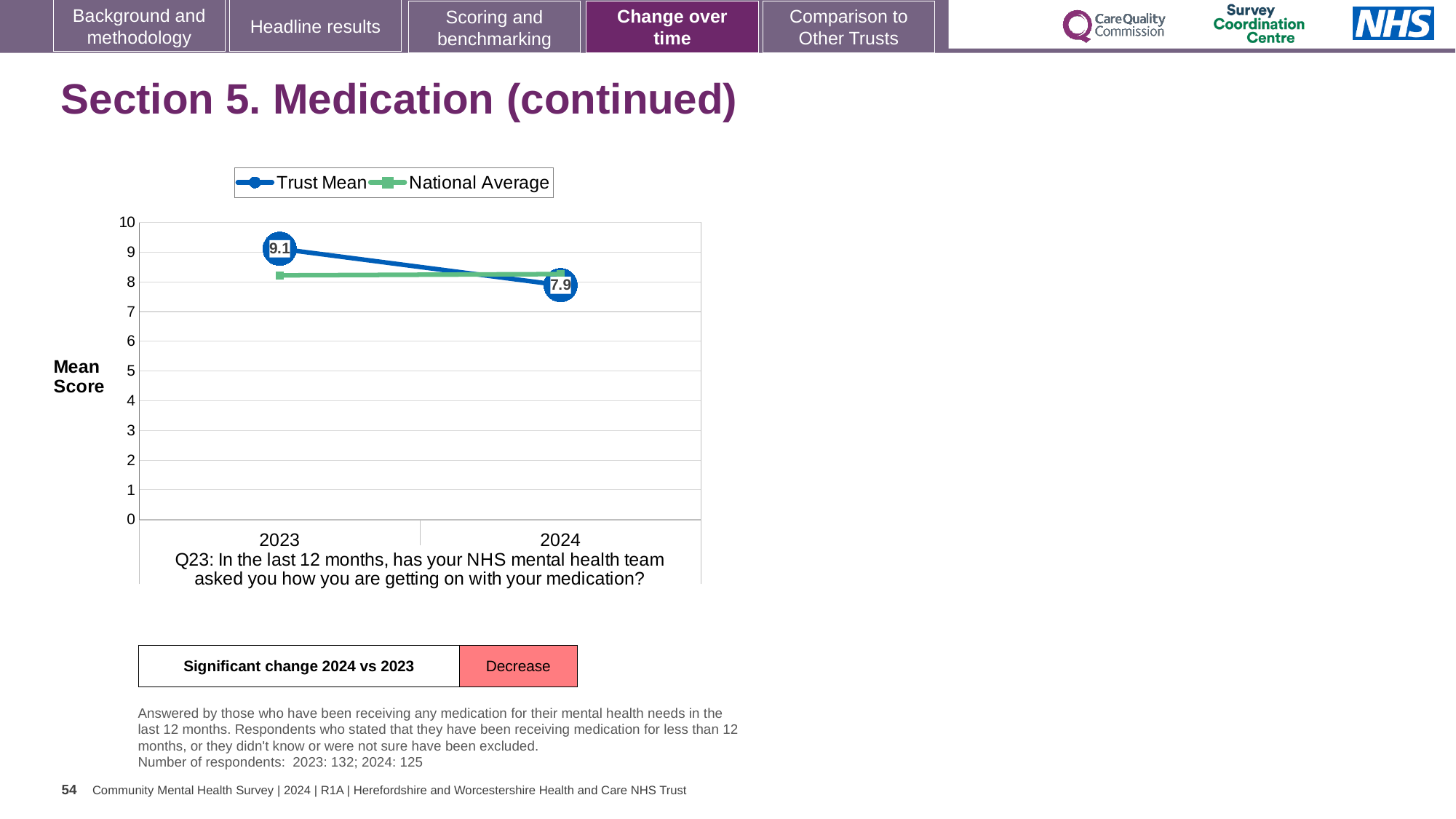
How many years are shown on the x axis? 2 Is the National Average value for 2024 greater or less than 7? greater In 2023, which is larger: the Trust Mean or the National Average? Trust Mean By how much did the Trust Mean change from 2023 to 2024? 1.2 Is the National Average value for 2023 greater or less than 9? less In which year is the Trust Mean highest? 2023 What kind of chart is shown on the slide? line chart Does the Trust Mean rise or fall from 2023 to 2024? fall In which year is the Trust Mean lowest? 2024 How many series does the legend list? 2 What is the Trust Mean value for 2023? 9.1 What is the Trust Mean value for 2024? 7.9